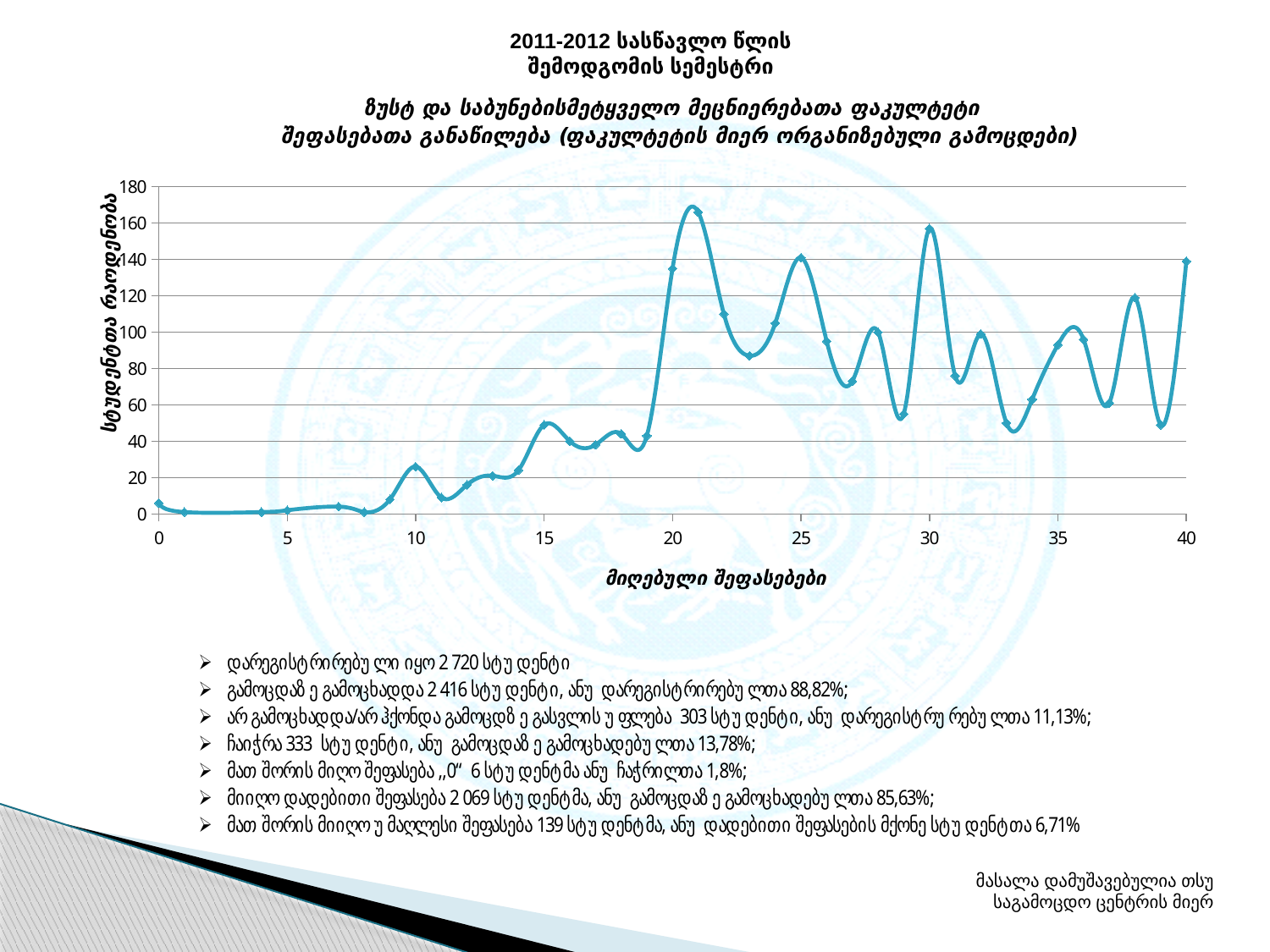
Is the value at score 20 greater or less than 120? greater Is the value at score 10 greater or less than 40? less What is the highest tick value shown on the y axis? 180 Is the value at score 39 greater or less than 60? less Which score has more students: 21 or 30? 21 At which score (x-axis value) does the line reach its highest number of students? 21 What is the label of the x axis? მიღებული შეფასებები What kind of chart is shown on the slide? line chart Which score has more students: 10 or 15? 15 Does the number of students rise or fall as the score goes from 0 to 10? rise